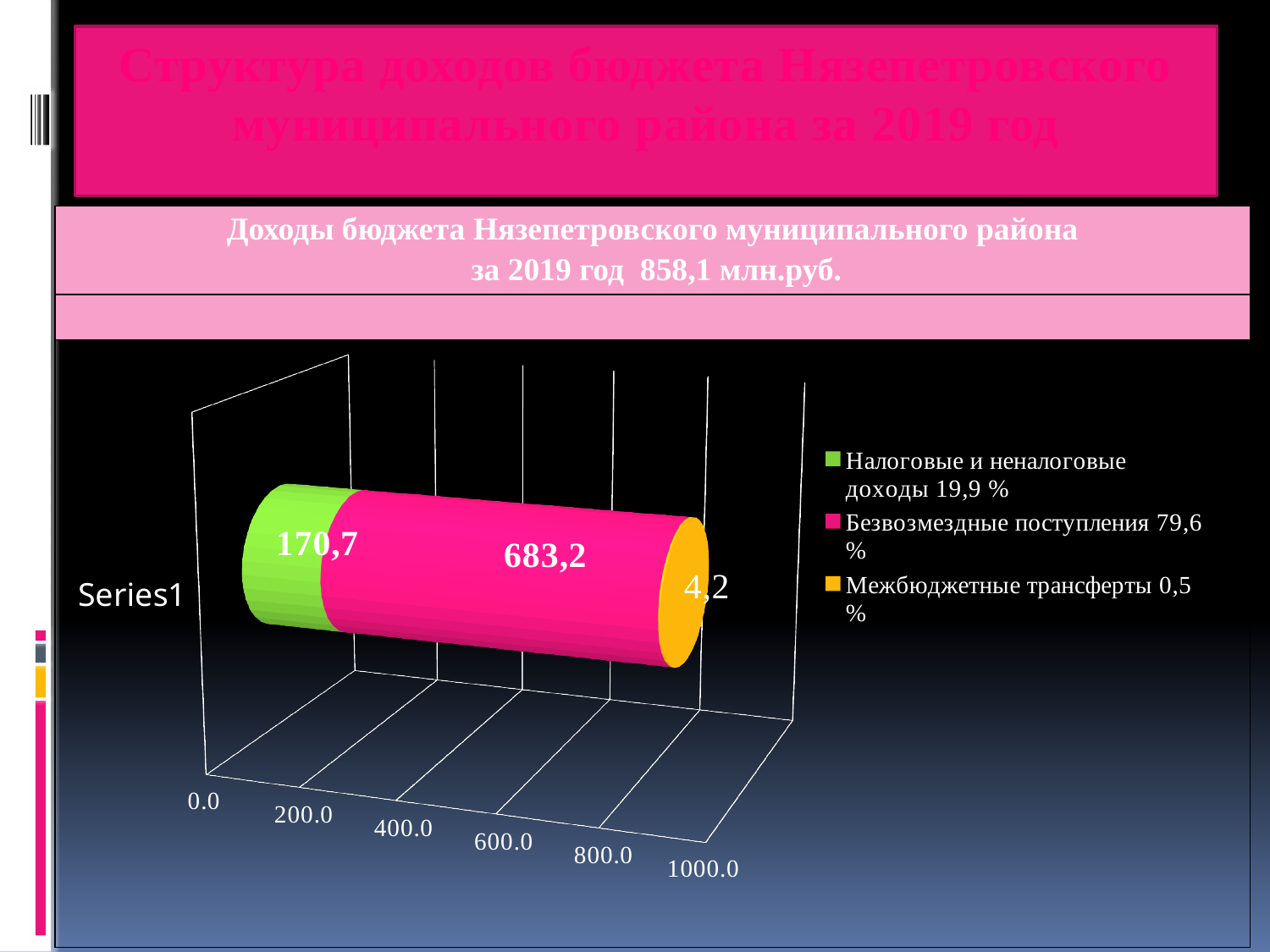
What percentage share is shown in the legend for Безвозмездные поступления? 79,6 % How many series does the legend list? 3 What is the difference between the Безвозмездные поступления value and the Налоговые и неналоговые доходы value? 512,5 What is the value of the Налоговые и неналоговые доходы segment? 170,7 What is the total of the stacked bar for Series1? 858,1 Which segment of the stacked bar has the largest value? Безвозмездные поступления What colour is the Межбюджетные трансферты segment? Orange Which is larger: the Налоговые и неналоговые доходы segment or the Межбюджетные трансферты segment? Налоговые и неналоговые доходы What is the value of the Безвозмездные поступления segment? 683,2 What is the value of the Межбюджетные трансферты segment? 4,2 Which segment of the stacked bar has the smallest value? Межбюджетные трансферты What kind of chart is shown on the slide? Stacked bar chart